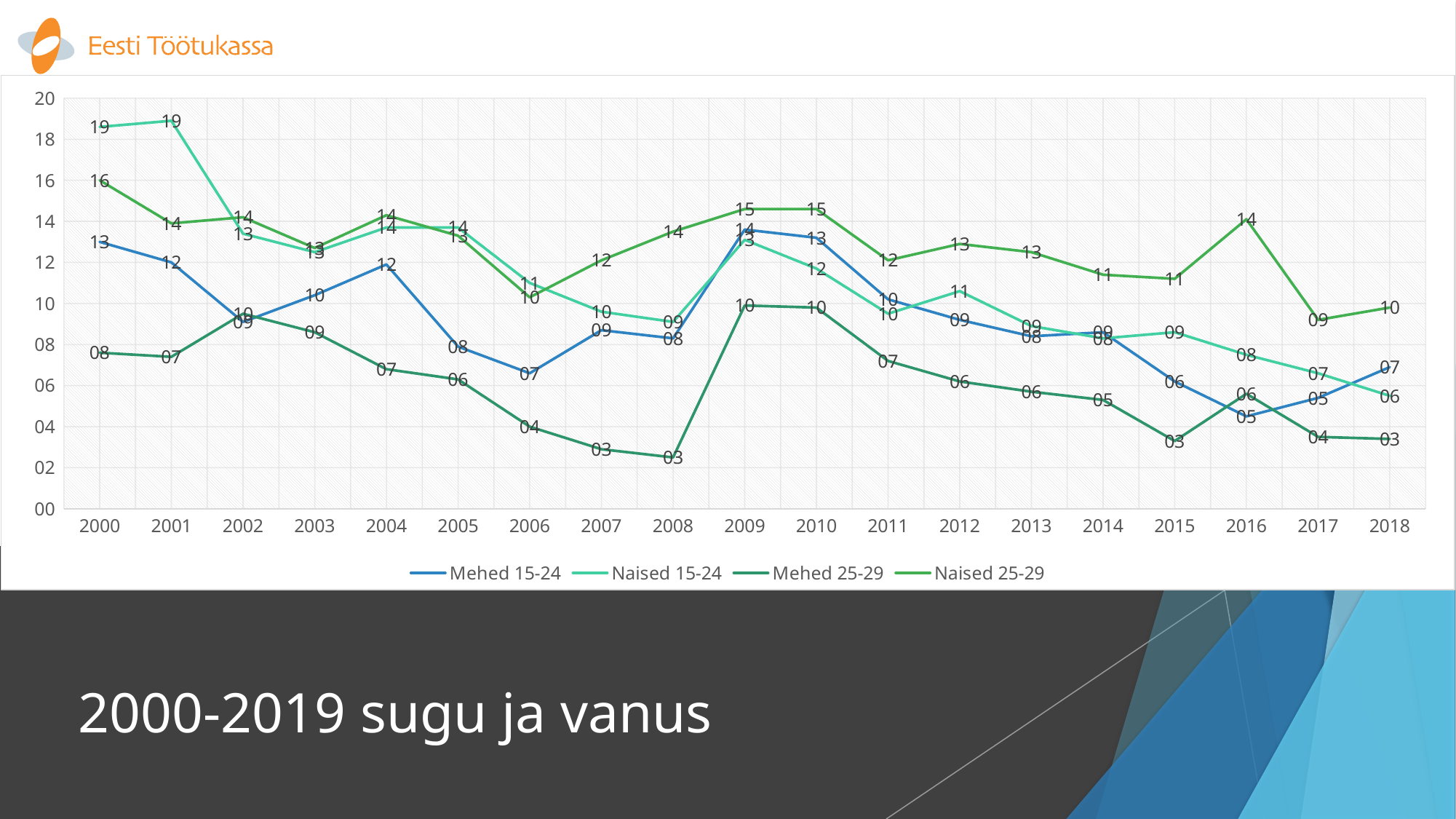
What is the value for Naised 25-29 in 2016? 14 What kind of chart is shown on the slide? line chart Does the value for Naised 15-24 rise or fall from 2013 to 2018? fall What is the value for Naised 15-24 in 2000? 19 Is the value for Naised 25-29 in 2009 greater or less than 14? greater What is the value for Mehed 25-29 in 2008? 03 In 2018, which is larger: Naised 25-29 or Mehed 15-24? Naised 25-29 In which year is the value for Naised 15-24 lowest? 2018 In which year is the value for Naised 25-29 highest? 2000 What is the difference between Naised 15-24 and Mehed 25-29 in 2000? 11 How many series does the legend list? 4 How many years are plotted along the x axis? 19